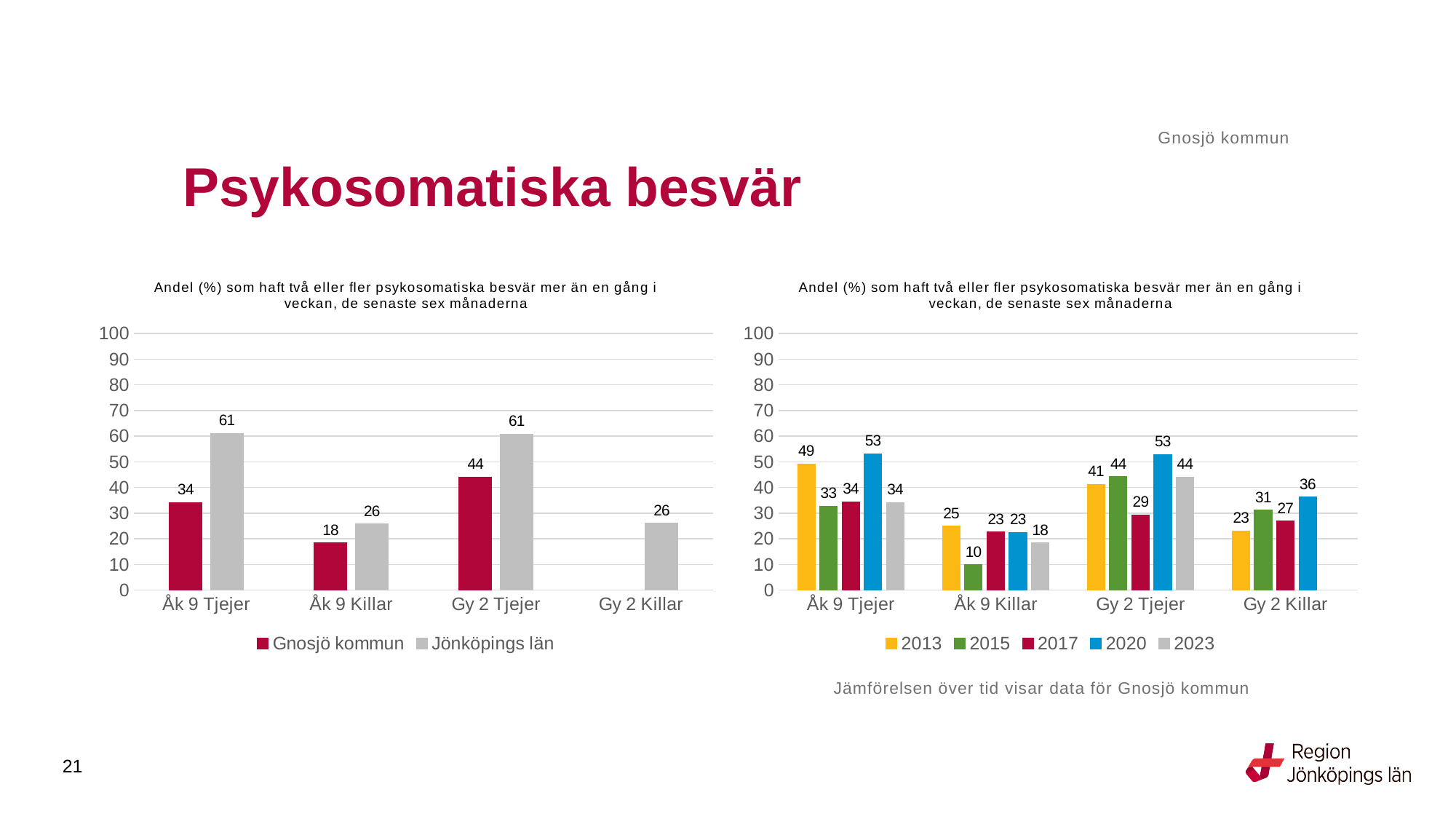
In the left chart, how many series does the legend list? 2 In the right chart, which year has the lowest value for Gy 2 Tjejer? 2017 In the right chart, which year has the highest value for Åk 9 Tjejer? 2020 In the left chart, which is larger for Gy 2 Tjejer: Gnosjö kommun or Jönköpings län? Jönköpings län In the left chart, what is the difference between Jönköpings län and Gnosjö kommun for Åk 9 Tjejer? 27 In the right chart, what is the value for 2015 for Åk 9 Killar? 10 In the right chart, what is the value for 2020 for Gy 2 Killar? 36 In the left chart, what is the value for Gnosjö kommun for Åk 9 Tjejer? 34 What kind of chart is the left chart? Bar chart In the right chart, what is the difference between the 2013 and 2023 values for Åk 9 Tjejer? 15 In the left chart, what is the value for Jönköpings län for Gy 2 Killar? 26 In the right chart, how many series does the legend list? 5